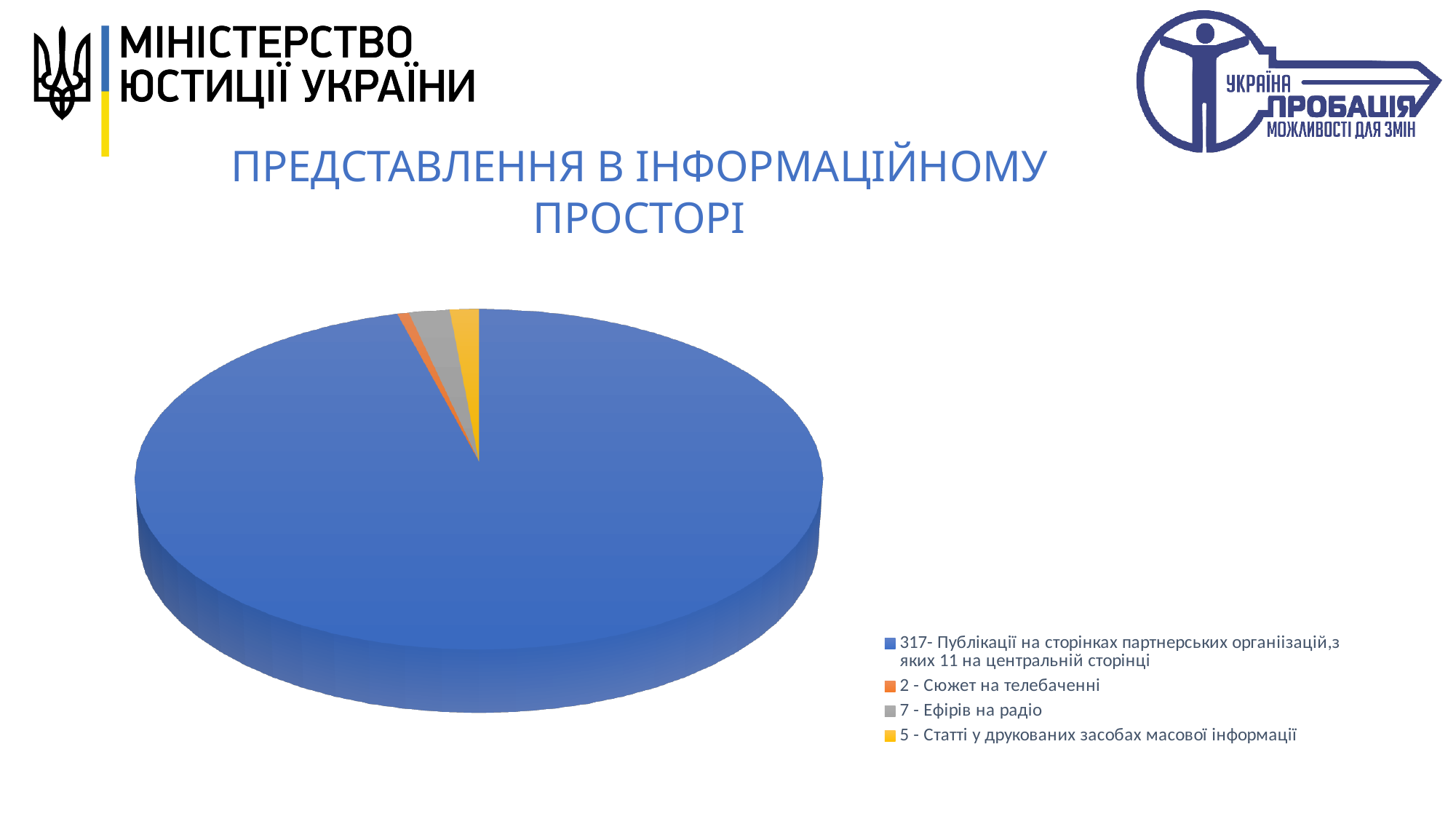
What is the difference between the value for Ефірів на радіо and the value for Статті у друкованих засобах масової інформації? 2 Which category has the smallest slice of the pie chart? Сюжет на телебаченні What is the value for Ефірів на радіо? 7 Which is larger: the value for Ефірів на радіо or the value for Сюжет на телебаченні? Ефірів на радіо What colour is the largest slice of the pie chart? Blue What is the title of the slide containing the pie chart? ПРЕДСТАВЛЕННЯ В ІНФОРМАЦІЙНОМУ ПРОСТОРІ What is the value for Статті у друкованих засобах масової інформації? 5 Which category has the largest slice of the pie chart? Публікації на сторінках партнерських організацій What kind of chart is shown on the slide? Pie chart What is the value for Сюжет на телебаченні? 2 How many categories does the pie chart have? 4 What is the value for Публікації на сторінках партнерських організацій? 317